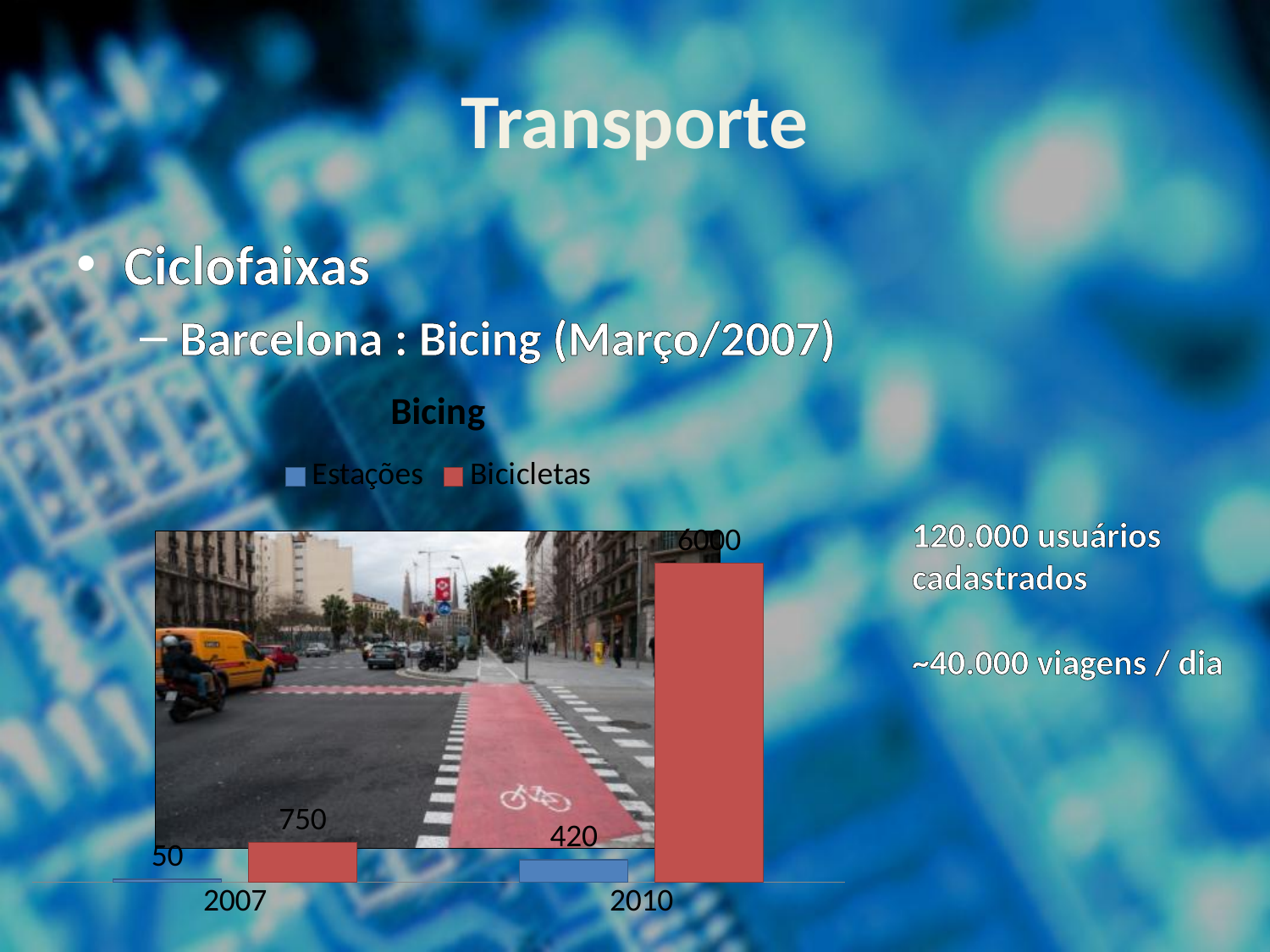
What is the value for Bicicletas in 2010? 6000 Do the Bicicletas values rise or fall from 2007 to 2010? rise What type of chart is shown on the slide? bar chart What is the value for Bicicletas in 2007? 750 How many series does the chart legend list? 2 What is the title of the chart? Bicing Which is larger in 2010, Estações or Bicicletas? Bicicletas What is the value for Estações in 2007? 50 What is the difference between the Estações values for 2010 and 2007? 370 How many categories are shown on the x axis of the chart? 2 What is the value for Estações in 2010? 420 Which year has the higher value for Bicicletas? 2010